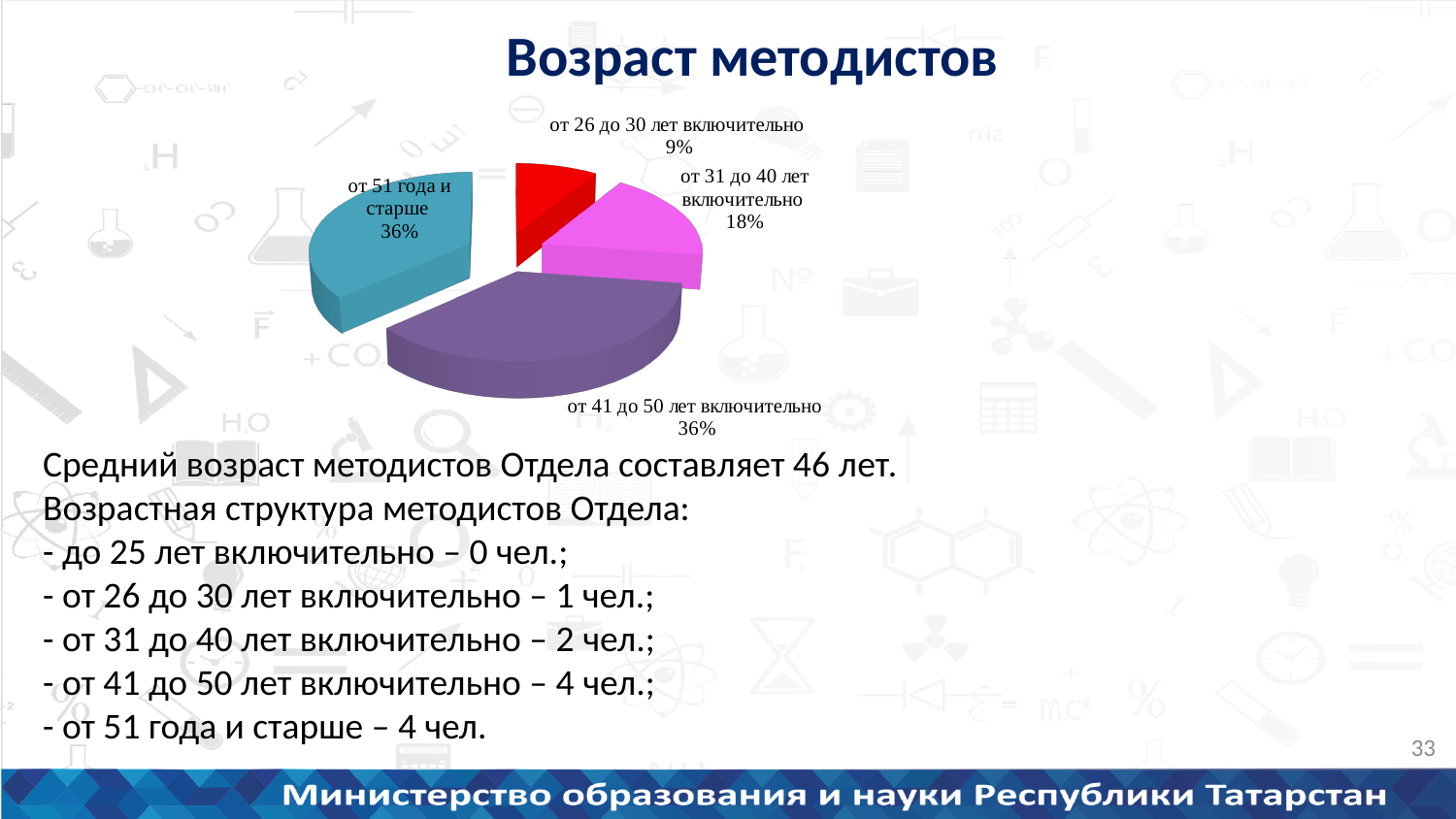
What is the difference in percentage points between the "от 41 до 50 лет включительно" slice and the "от 26 до 30 лет включительно" slice? 27 What is the title of the chart? Возраст методистов What kind of chart is shown on the slide? Pie chart Which slice is larger: "от 31 до 40 лет включительно" or "от 51 года и старше"? от 51 года и старше What colour is the slice for "от 26 до 30 лет включительно"? Red What share of the pie is labelled "от 51 года и старше"? 36% Which age group has the smallest slice of the pie? от 26 до 30 лет включительно What share of the pie is labelled "от 31 до 40 лет включительно"? 18% How many slices does the pie chart have? 4 What share of the pie is labelled "от 41 до 50 лет включительно"? 36% What is the difference in percentage points between the "от 31 до 40 лет включительно" slice and the "от 26 до 30 лет включительно" slice? 9